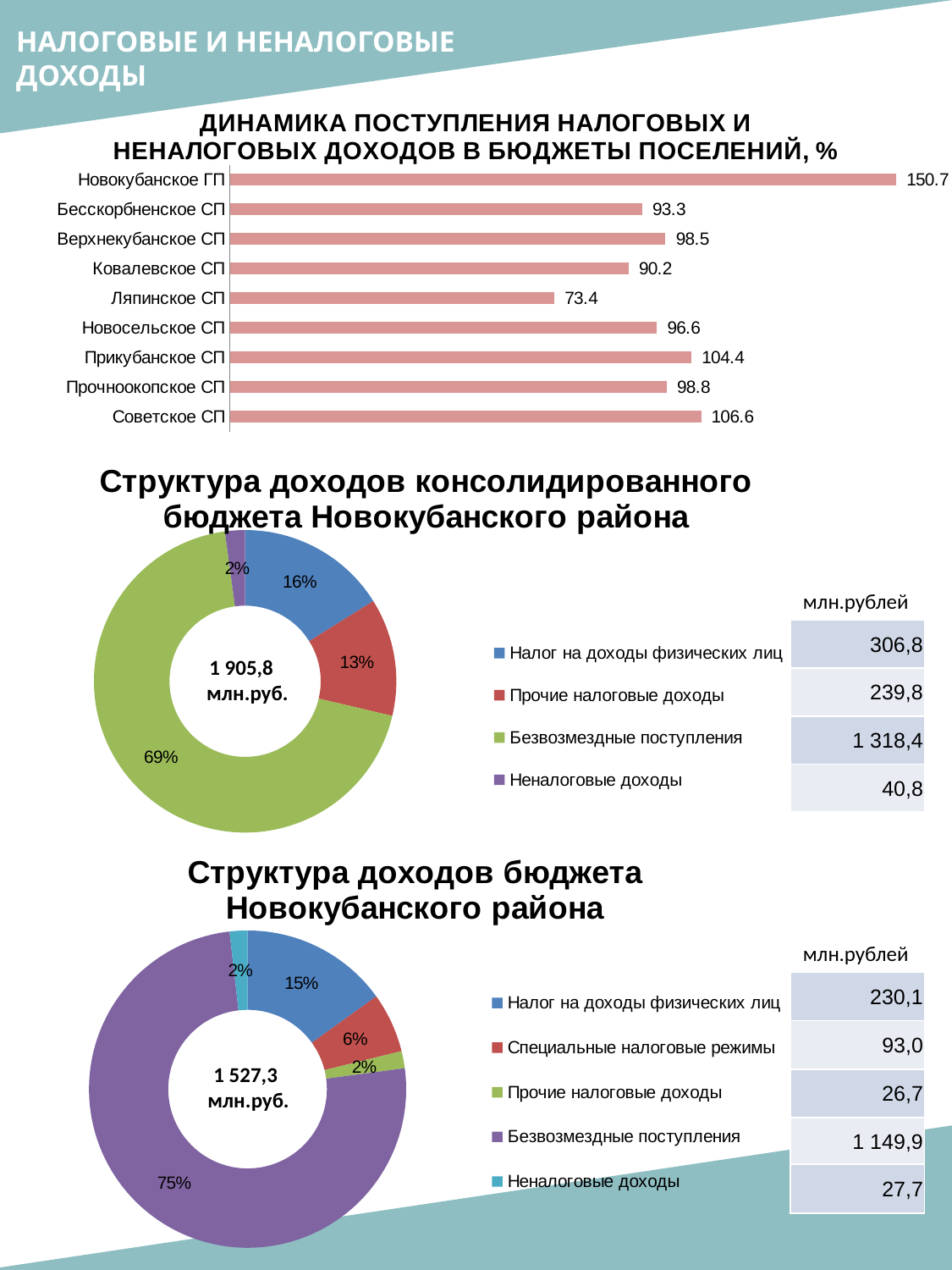
In the bar chart 'Динамика поступления налоговых и неналоговых доходов в бюджеты поселений, %', what is the difference between the values for Советское СП and Прикубанское СП? 2.2 In the bar chart 'Динамика поступления налоговых и неналоговых доходов в бюджеты поселений, %', which is larger: the value for Бесскорбненское СП or Ковалевское СП? Бесскорбненское СП What type of chart is 'Динамика поступления налоговых и неналоговых доходов в бюджеты поселений, %'? Bar chart In the bar chart 'Динамика поступления налоговых и неналоговых доходов в бюджеты поселений, %', what is the value for Новокубанское ГП? 150.7 In the chart 'Структура доходов консолидированного бюджета Новокубанского района', what total amount is shown in the centre of the doughnut? 1 905,8 млн.руб. How many series does the legend list in the chart 'Структура доходов бюджета Новокубанского района'? 5 In the bar chart 'Динамика поступления налоговых и неналоговых доходов в бюджеты поселений, %', which settlement has the lowest value? Ляпинское СП In the bar chart 'Динамика поступления налоговых и неналоговых доходов в бюджеты поселений, %', which settlement has the highest value? Новокубанское ГП In the chart 'Структура доходов консолидированного бюджета Новокубанского района', what share does Безвозмездные поступления have? 69% How many settlements are shown in the bar chart 'Динамика поступления налоговых и неналоговых доходов в бюджеты поселений, %'? 9 In the chart 'Структура доходов бюджета Новокубанского района', what share does Налог на доходы физических лиц have? 15% In the bar chart 'Динамика поступления налоговых и неналоговых доходов в бюджеты поселений, %', what is the value for Ляпинское СП? 73.4